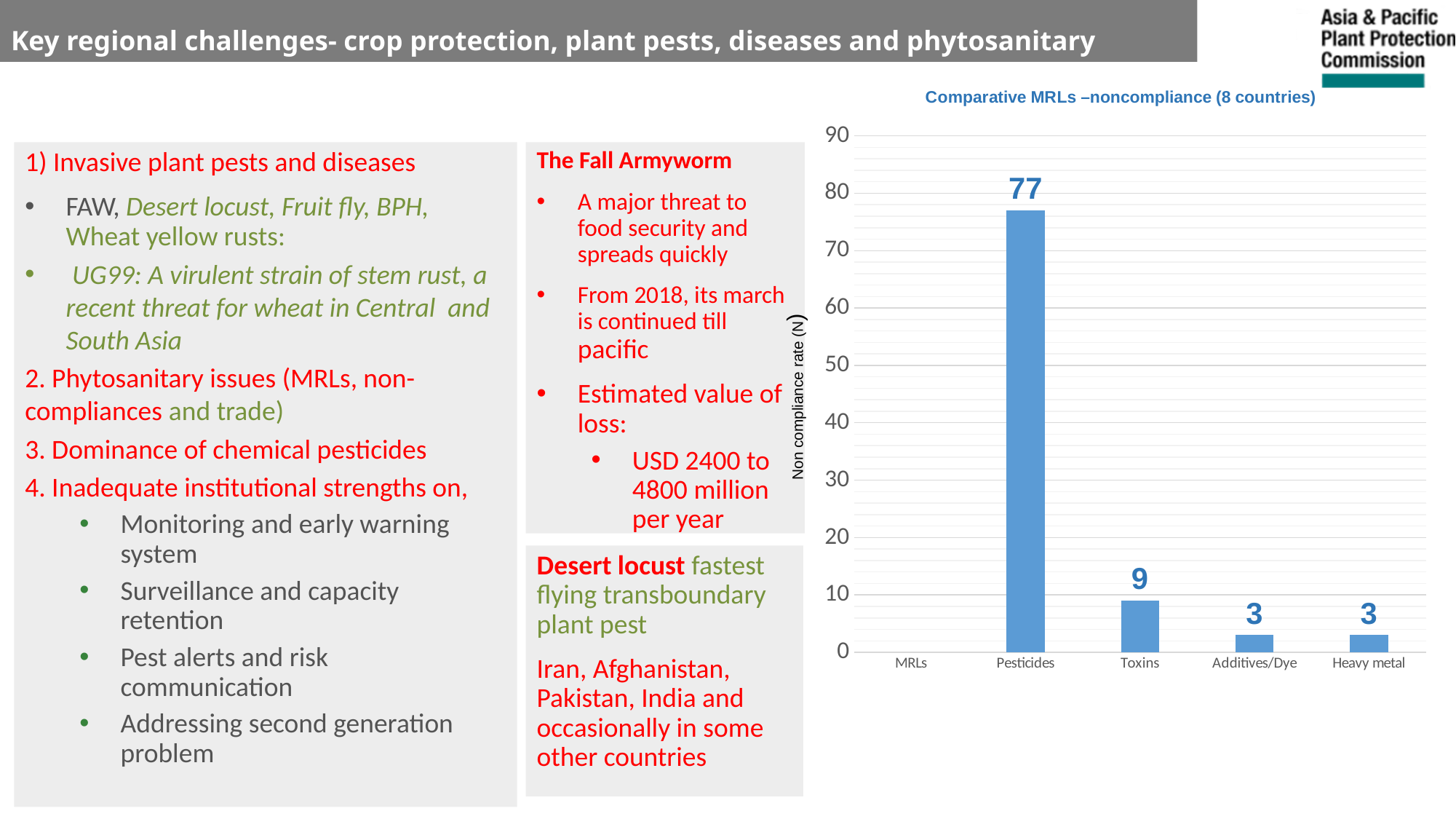
What kind of chart is shown on the slide? bar chart How many categories are labeled on the x axis of the chart? 5 Is the value for Pesticides greater or less than 70? greater What is the value for Additives/Dye in the chart? 3 What is the value for Toxins in the chart? 9 What is the difference between the values for Pesticides and Toxins? 68 Which is larger, the value for Toxins or the value for Additives/Dye? Toxins What is the value for Pesticides in the chart? 77 Which category has the highest non compliance rate in the chart? Pesticides What is the title of the chart? Comparative MRLs –noncompliance (8 countries) What is the difference between the values for Toxins and Heavy metal? 6 What is the value for Heavy metal in the chart? 3